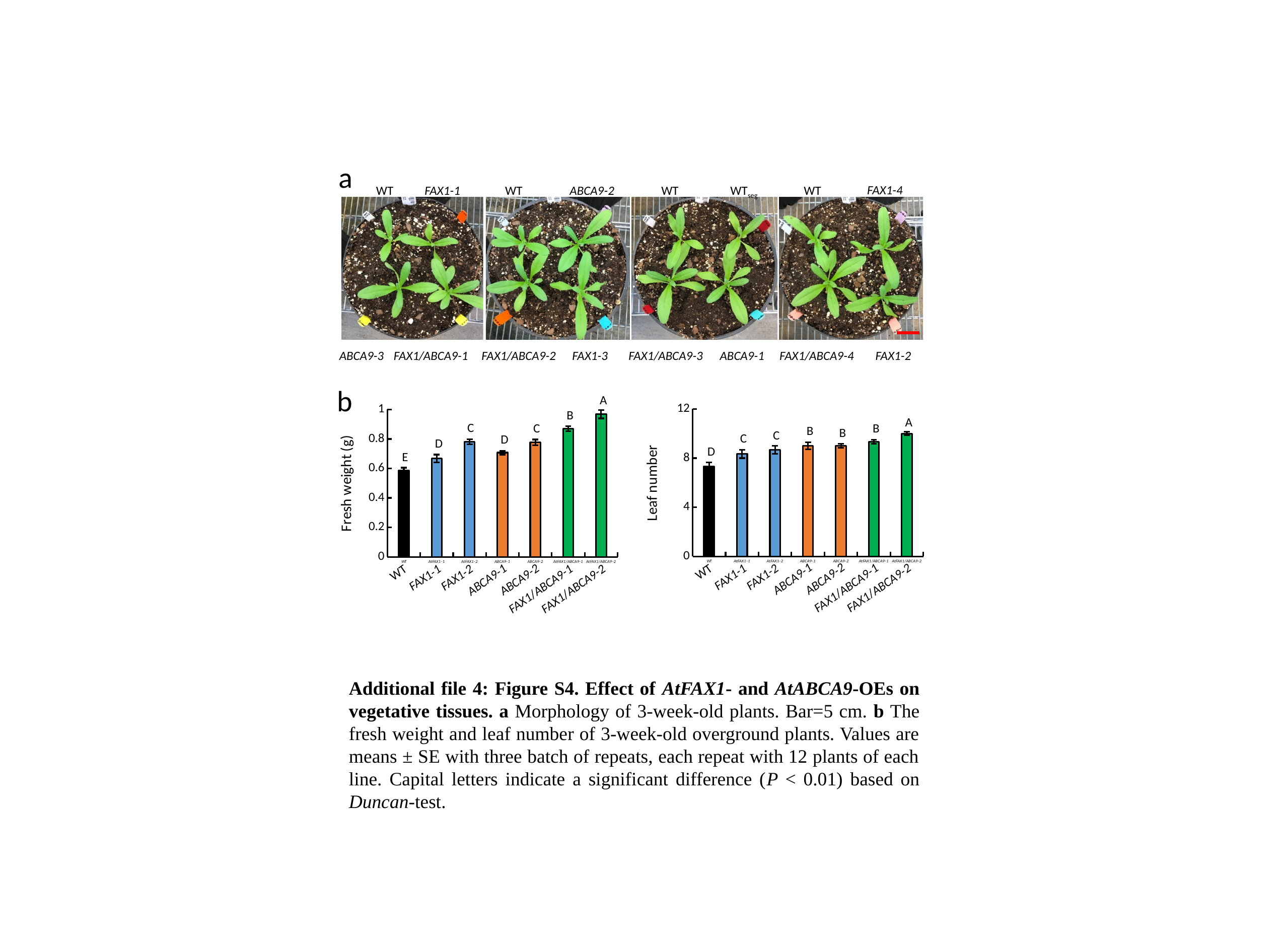
In the Leaf number chart, which category has the highest value? FAX1/ABCA9-2 How many categories are shown on the x axis of the Leaf number chart? 7 In the Fresh weight (g) chart, is the value for FAX1/ABCA9-2 greater or less than 0.8? greater In the Leaf number chart, is the value for WT greater or less than 8? less In the Fresh weight (g) chart, is the value for ABCA9-1 greater or less than 0.8? less In the Fresh weight (g) chart, what significance letter is printed above the FAX1/ABCA9-2 bar? A What kind of chart is the Fresh weight (g) chart in panel b? bar chart In the Fresh weight (g) chart, which category has the highest value? FAX1/ABCA9-2 In the Fresh weight (g) chart, which category has the lowest value? WT In the Leaf number chart, which category has the lowest value? WT In the Fresh weight (g) chart, which is larger, the value for FAX1-2 or the value for ABCA9-1? FAX1-2